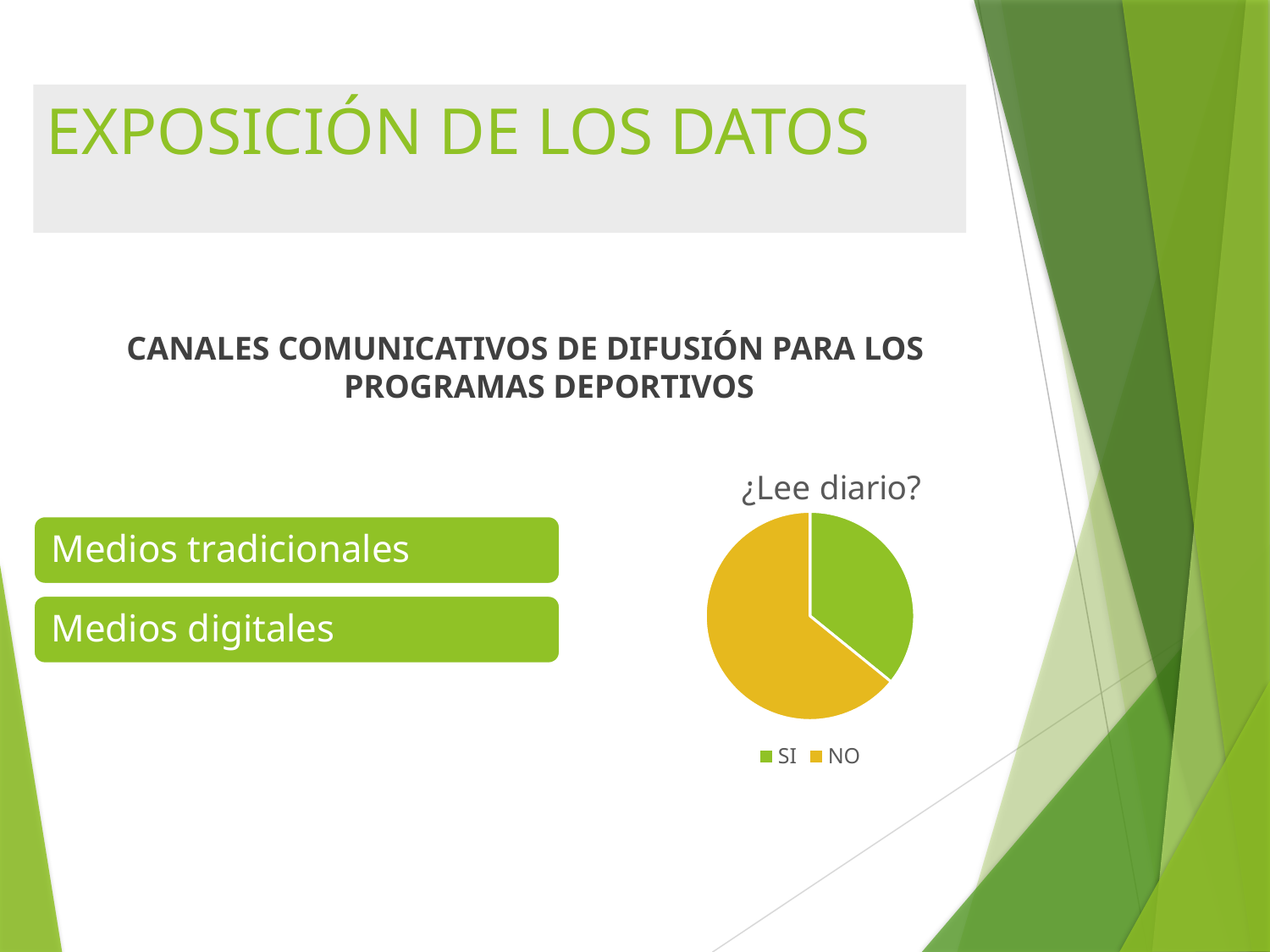
Which slice of the pie chart is the largest? NO How many slices does the pie chart have? 2 What is the title of the pie chart? ¿Lee diario? What kind of chart is shown on the slide? pie chart How many entries does the legend of the pie chart list? 2 What colour is the SI slice in the pie chart? green Which slice of the pie chart is the smallest? SI In the pie chart, which is larger, the SI slice or the NO slice? NO